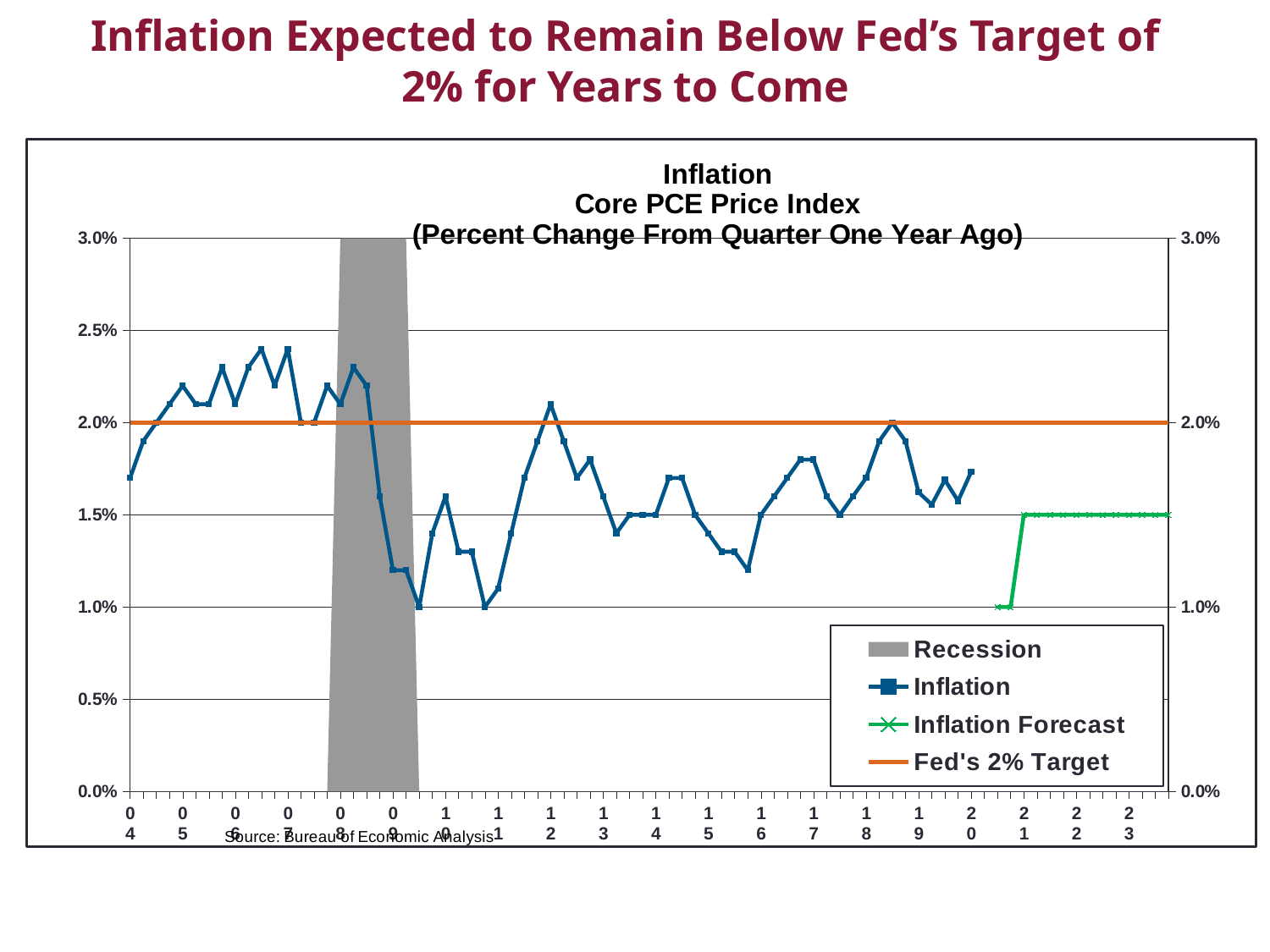
Is the Inflation Forecast value in 2023 greater or less than 2.0%? less What does the grey shaded area on the chart represent? Recession Does the Inflation Forecast line rise or fall from its start to its end? rise What is the title of the chart? Inflation Core PCE Price Index (Percent Change From Quarter One Year Ago) What kind of chart is shown on the slide? line chart At what value does the Inflation Forecast line level off through 2023? 1.5% Is the lowest Inflation value around 2010 greater or less than 1.5%? less Is the highest value of the Inflation line greater or less than 2.0%? greater At what value is the Fed's 2% Target line drawn? 2.0% How many entries does the chart legend list? 4 Is the Inflation Forecast at the end of the chart higher or lower than the Fed's 2% Target line? lower